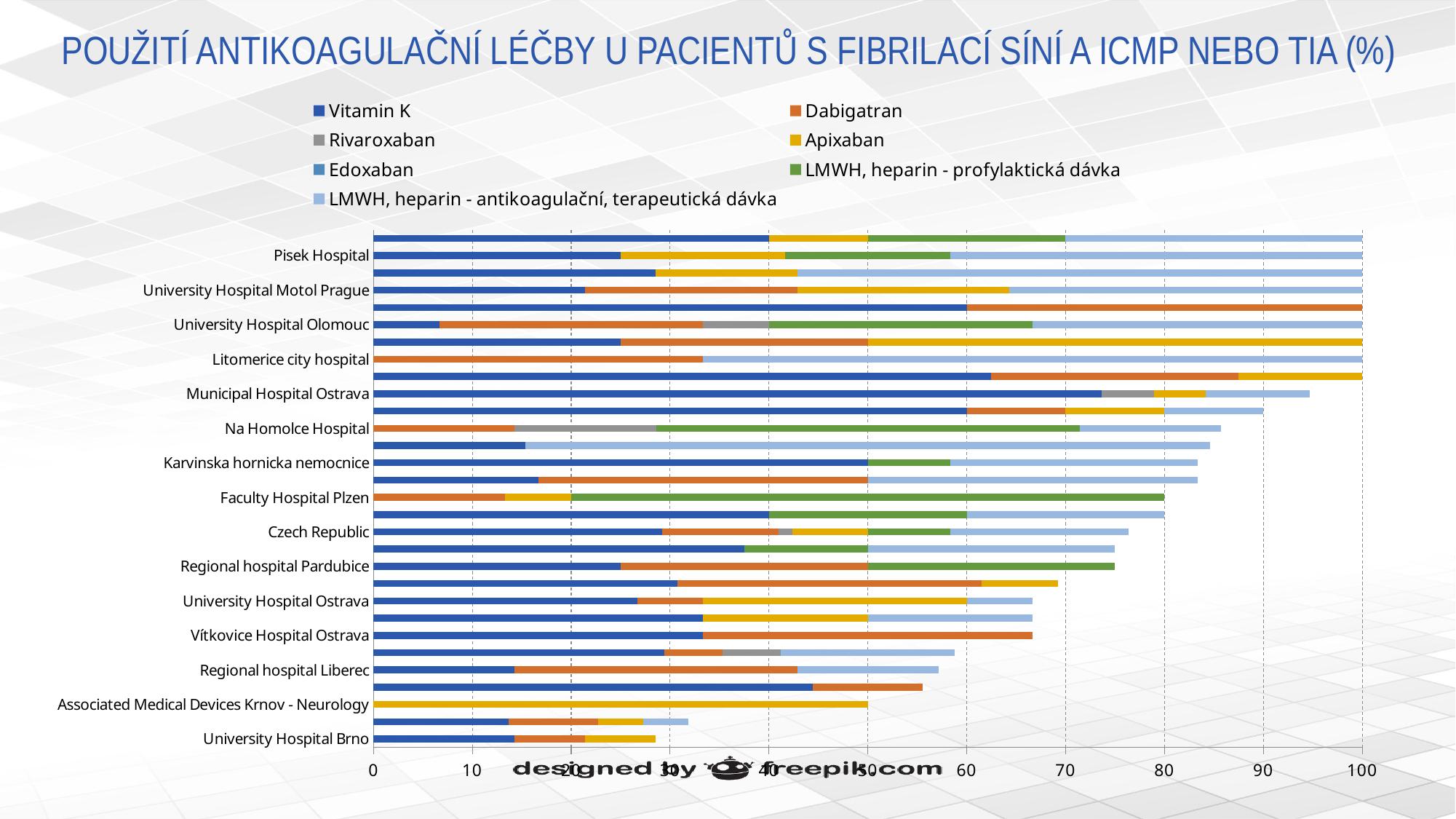
Which legend entry is shown in green? LMWH, heparin - profylaktická dávka Is the total bar length for Municipal Hospital Ostrava greater or less than 90? greater What kind of chart is shown on the slide? Stacked horizontal bar chart Is the total bar length for Regional hospital Liberec greater or less than 50? greater Is the total bar length for University Hospital Brno greater or less than 30? less How many hospital/category labels are shown on the vertical axis? 15 How many series does the chart legend list? 7 Among the labelled hospitals, which has the shortest total bar? University Hospital Brno Which has the longer total bar: University Hospital Olomouc or Municipal Hospital Ostrava? University Hospital Olomouc What is the title of the chart on the slide? POUŽITÍ ANTIKOAGULAČNÍ LÉČBY U PACIENTŮ S FIBRILACÍ SÍNÍ A ICMP NEBO TIA (%) Which has the longer total bar: Regional hospital Liberec or Regional hospital Pardubice? Regional hospital Pardubice